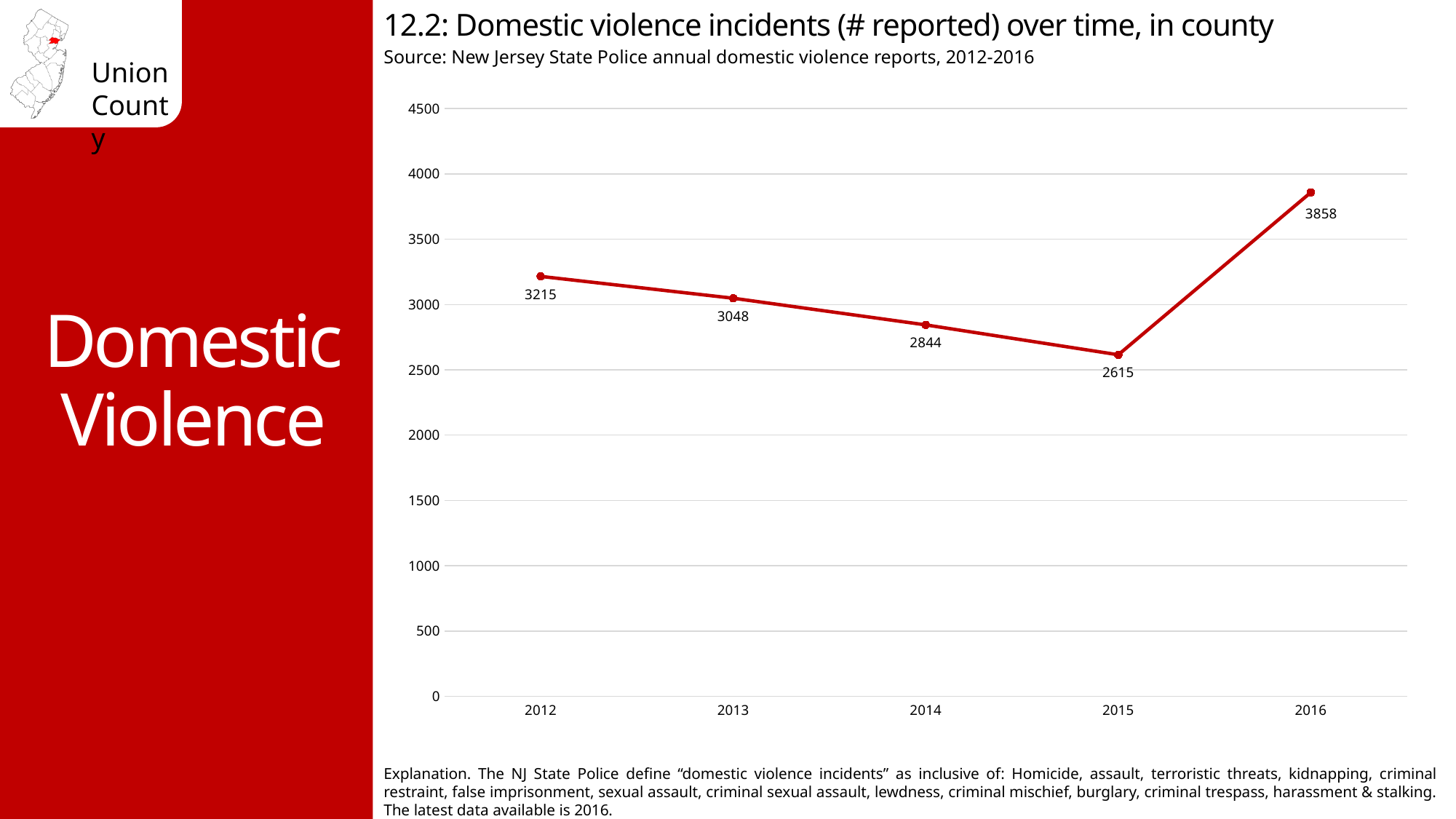
What is the number of reported domestic violence incidents in 2012? 3215 What is the number of reported domestic violence incidents in 2015? 2615 Which year has the lowest number of reported domestic violence incidents? 2015 What kind of chart is shown on the slide? line chart What is the difference between the number of incidents in 2016 and 2015? 1243 Do the values rise or fall from 2012 to 2015? fall How many years are plotted on the chart? 5 What is the number of reported domestic violence incidents in 2016? 3858 Is the value for 2014 greater or less than 3000? less Which year has the highest number of reported domestic violence incidents? 2016 What is the difference between the number of incidents in 2012 and 2013? 167 Which year had more reported incidents, 2013 or 2014? 2013